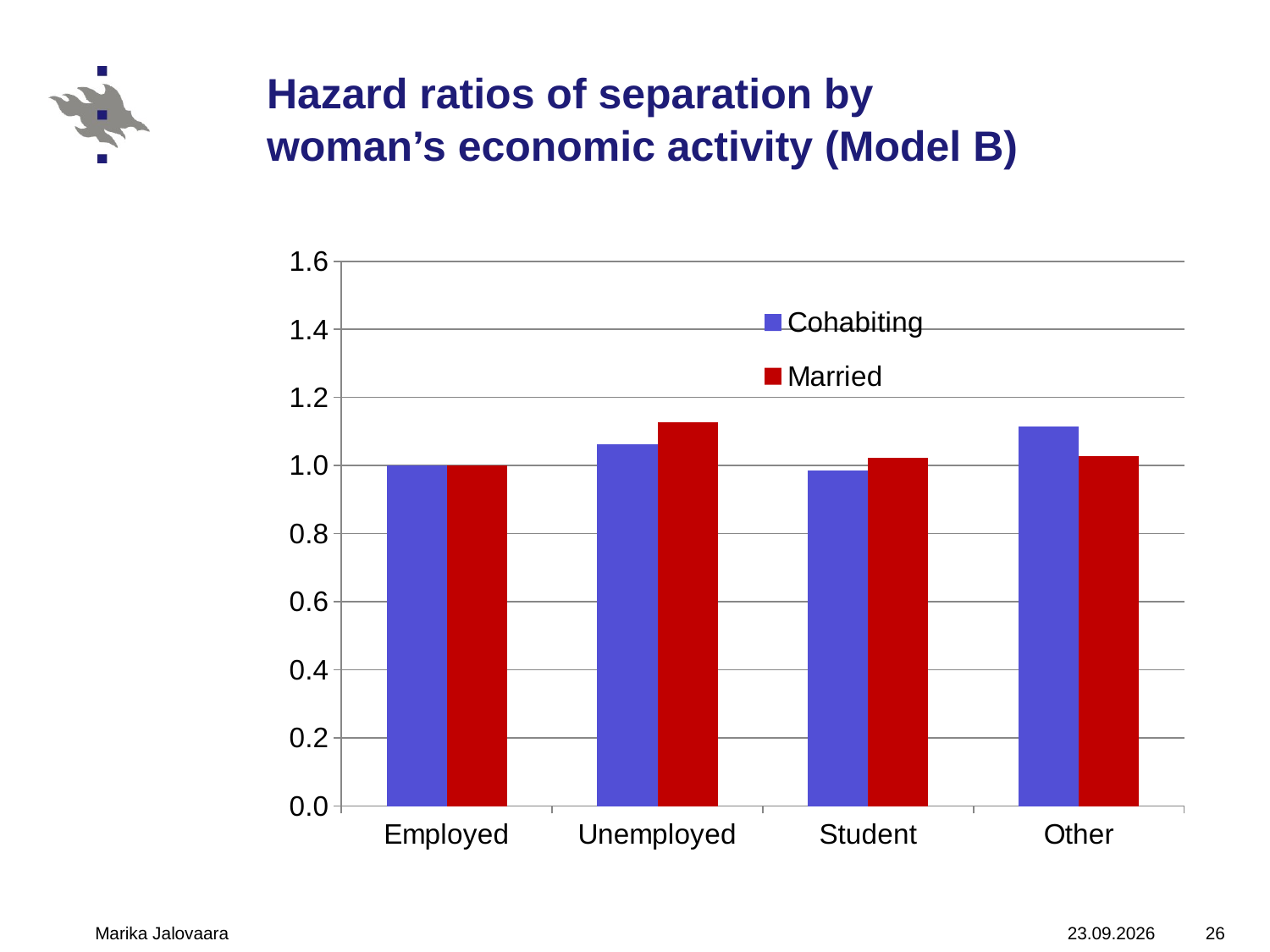
Is the Married value for Unemployed greater or less than 1.2? less Which colour represents the Married series? red Is the Cohabiting value for Other greater or less than 1.0? greater Is the Married value for Unemployed greater or less than 1.0? greater Which category has the highest hazard ratio for the Married series? Unemployed How many series does the legend list? 2 What is the hazard ratio for Married women in the Employed category? 1.0 What kind of chart is shown on the slide? bar chart Which category has the highest hazard ratio for the Cohabiting series? Other How many economic activity categories are shown on the x axis? 4 What is the hazard ratio for Cohabiting women in the Employed category? 1.0 In the Unemployed category, which series has the larger value, Cohabiting or Married? Married